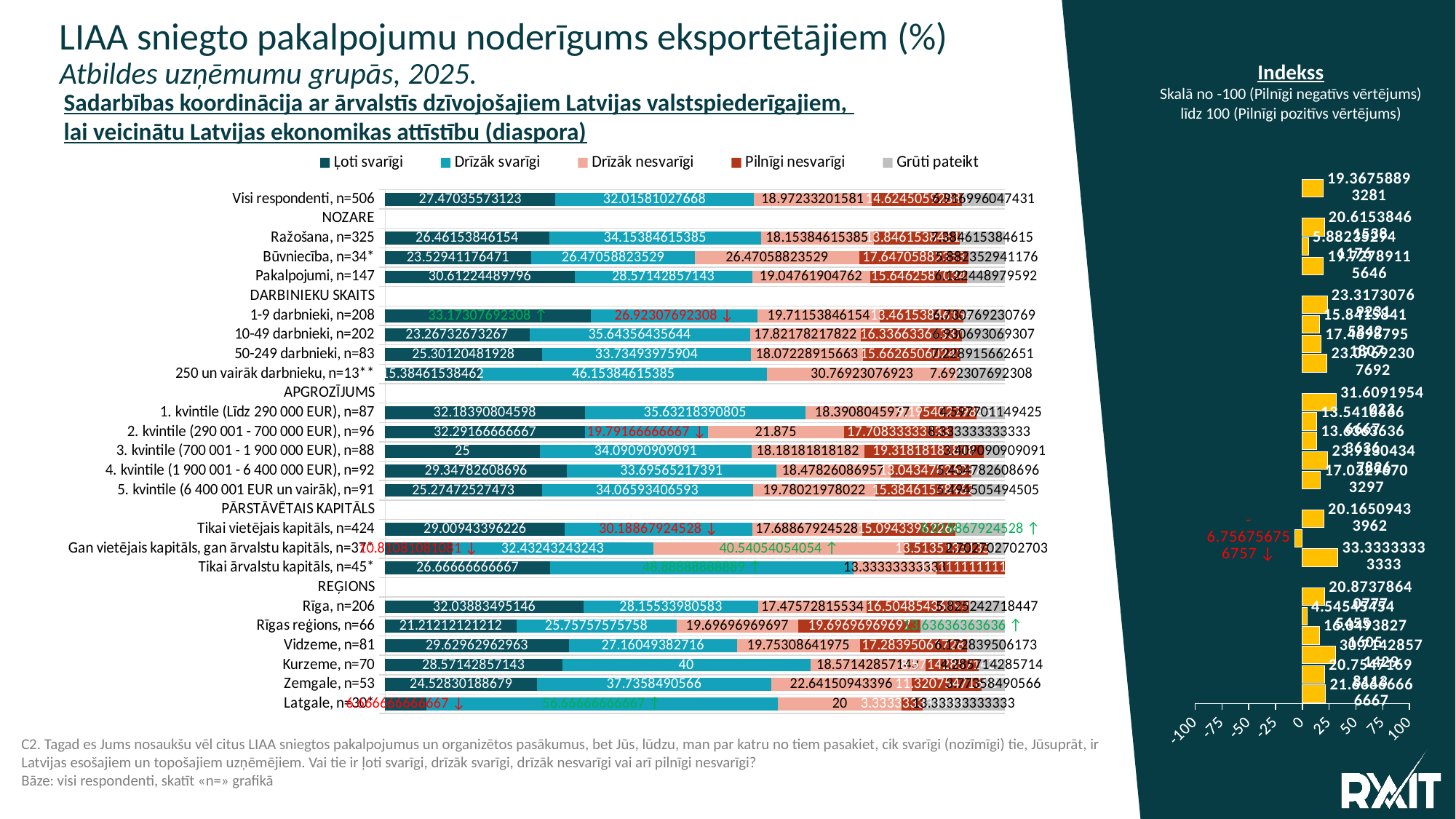
In the main chart, what is the 'Drīzāk nesvarīgi' value for Latgale, n=30*? 20 In the main chart, what is the 'Drīzāk svarīgi' value for Kurzeme, n=70? 40 What kind of chart is the main chart on the left of the slide? bar chart In the main chart, what is the 'Ļoti svarīgi' value for 3. kvintile (700 001 - 1 900 000 EUR), n=88? 25 In the Indekss chart, is the value for Visi respondenti, n=506 greater or less than 25? less In the main chart, what is the difference between the 'Drīzāk svarīgi' value for Kurzeme, n=70 and the 'Ļoti svarīgi' value for 3. kvintile (700 001 - 1 900 000 EUR), n=88? 15 In the main chart, what is the 'Ļoti svarīgi' value for Visi respondenti, n=506? 27.47035573123 In the main chart, which has the larger 'Drīzāk svarīgi' value: Kurzeme, n=70 or Rīga, n=206? Kurzeme, n=70 How many series does the legend of the main chart list? 5 In the Indekss chart, which group has a negative index value? Gan vietējais kapitāls, gan ārvalstu kapitāls, n=37 In the main chart, which group has the highest 'Drīzāk svarīgi' value? Latgale, n=30* In the main chart, what is the 'Drīzāk svarīgi' value for 250 un vairāk darbinieku, n=13**? 46.15384615385